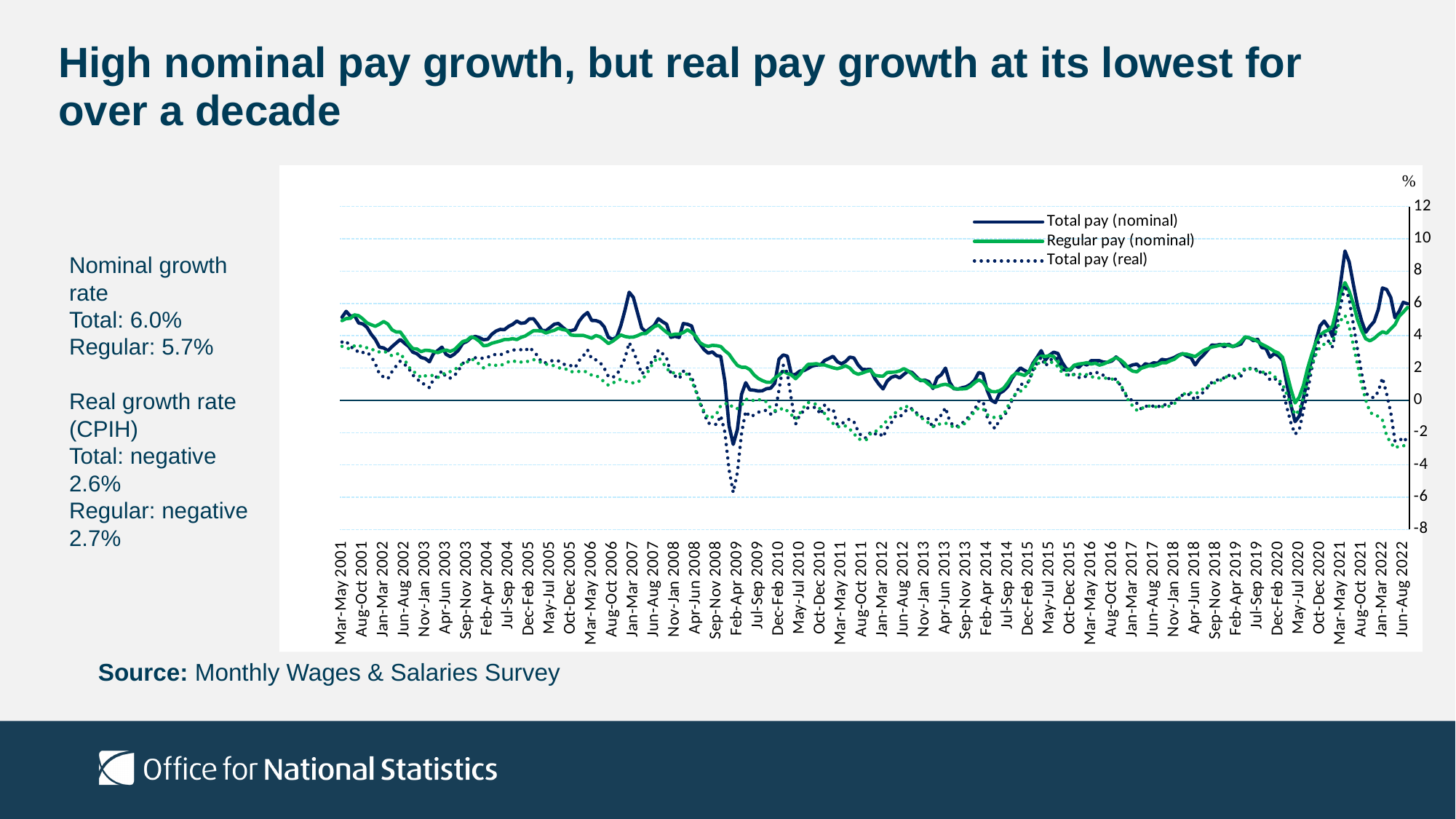
Which series reaches the lowest value anywhere on the chart? Total pay (real) According to the slide, what is the real (CPIH) growth rate for regular pay? negative 2.7% Which series reaches the highest value anywhere on the chart? Total pay (nominal) Which series is drawn as a dotted line in the chart? Total pay (real) How many series does the chart legend list? 3 Is the peak value of Total pay (nominal) around Mar-May 2021 greater or less than 8? greater Is the value of Total pay (real) around Feb-Apr 2009 greater or less than -4? less Does Total pay (real) rise or fall between Mar-May 2021 and Jun-Aug 2022? fall What unit is shown at the top of the chart's vertical axis? % According to the slide, what is the nominal growth rate for regular pay? 5.7% According to the slide, what is the nominal growth rate for total pay? 6.0% What type of chart is shown on the slide? line chart